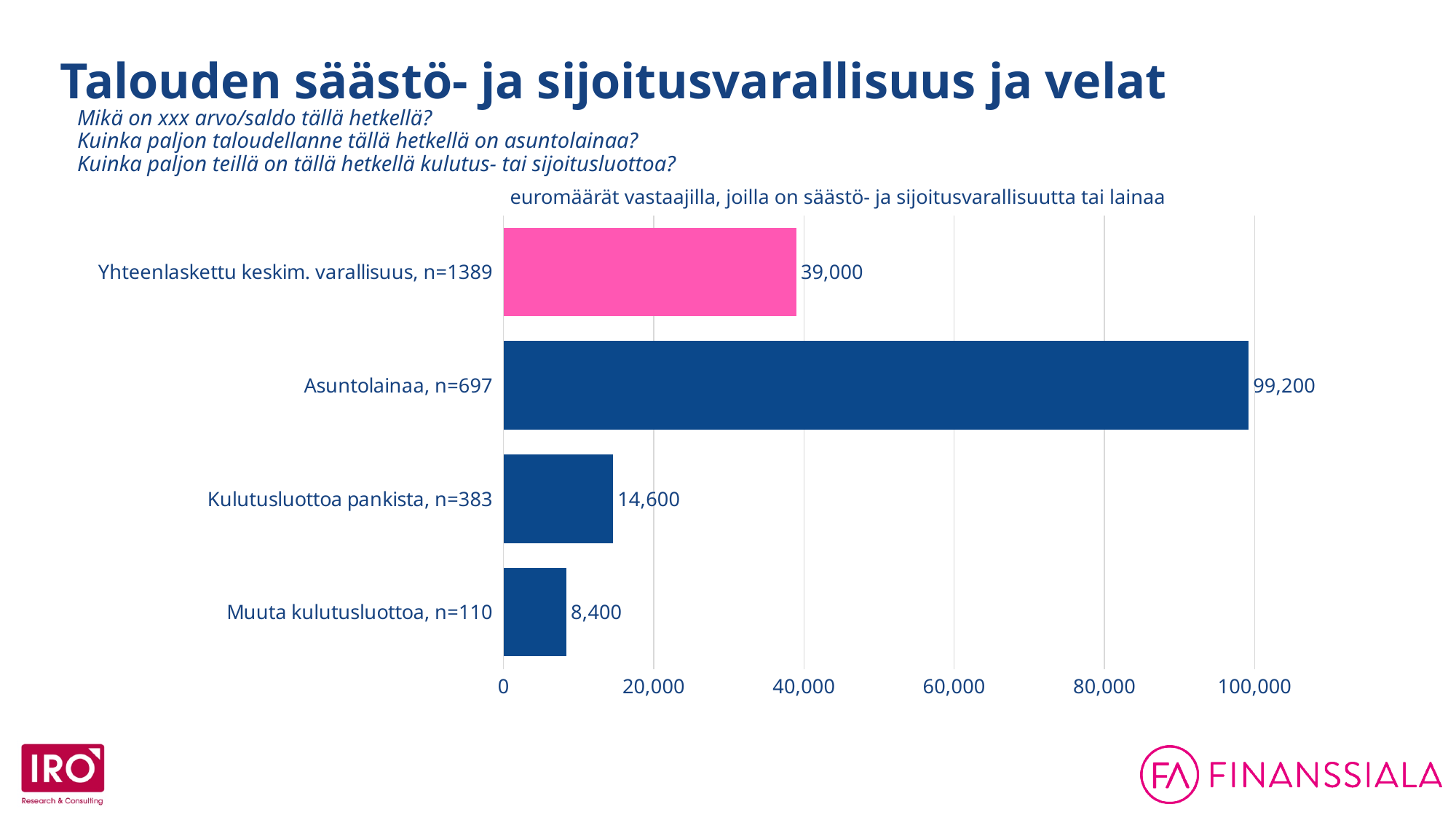
What is the value for Kulutusluottoa pankista, n=383? 14,600 Which is larger: the value for Kulutusluottoa pankista, n=383 or Muuta kulutusluottoa, n=110? Kulutusluottoa pankista, n=383 What kind of chart is shown on the slide? bar chart Is the value for Yhteenlaskettu keskim. varallisuus, n=1389 greater or less than 40,000? less What is the value for Asuntolainaa, n=697? 99,200 Which category has the highest value? Asuntolainaa, n=697 What is the difference between the values for Kulutusluottoa pankista, n=383 and Muuta kulutusluottoa, n=110? 6,200 What is the value for Muuta kulutusluottoa, n=110? 8,400 How many categories are shown in the chart? 4 What is the difference between the values for Asuntolainaa, n=697 and Yhteenlaskettu keskim. varallisuus, n=1389? 60,200 Which category has the lowest value? Muuta kulutusluottoa, n=110 What is the value for Yhteenlaskettu keskim. varallisuus, n=1389? 39,000